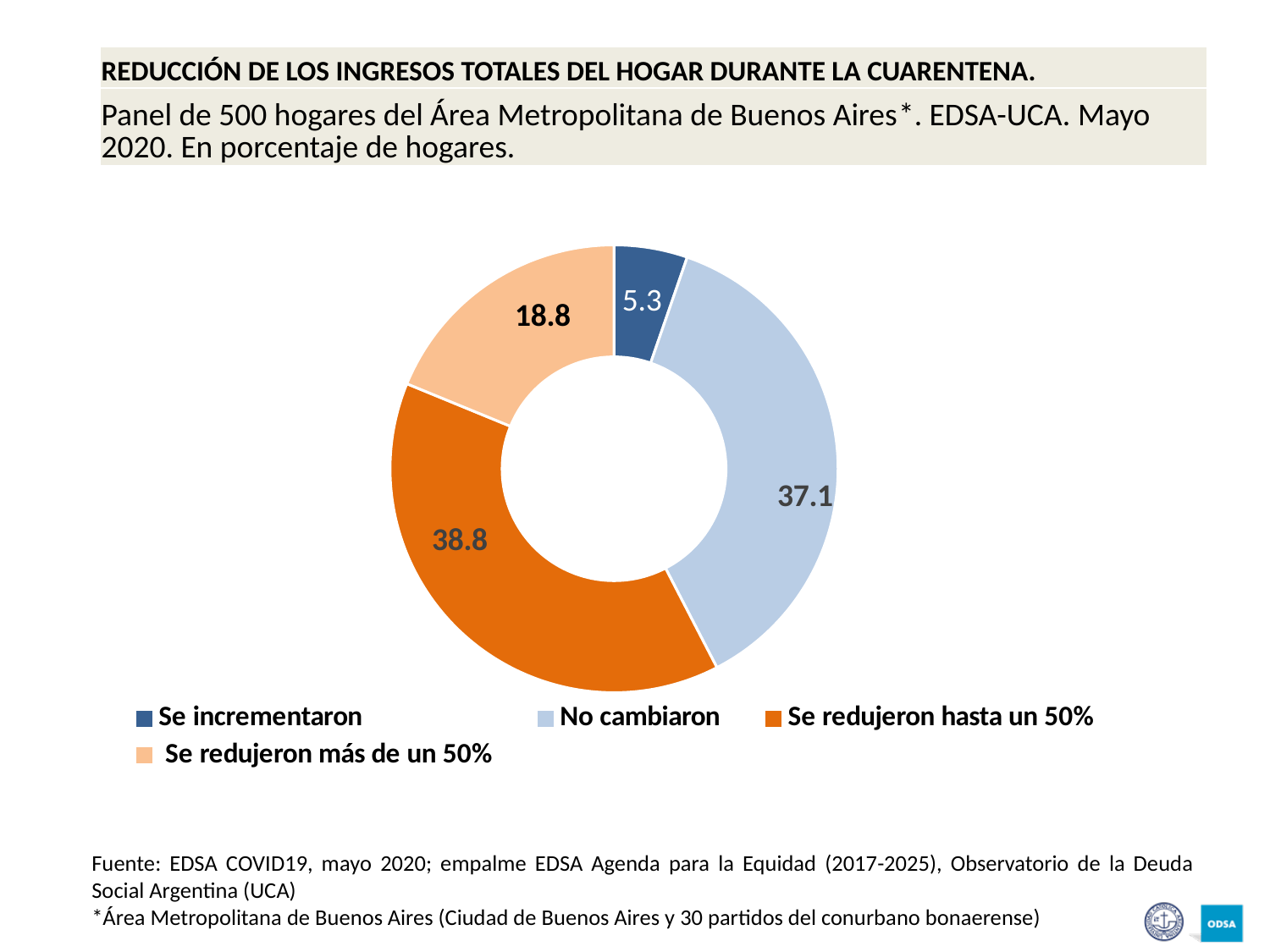
What percentage of households reported that their income 'Se incrementaron'? 5.3 Which colour represents 'Se incrementaron' in the chart? Dark blue What is the combined value of the two 'Se redujeron' categories? 57.6 What value is shown for 'Se redujeron más de un 50%'? 18.8 What kind of chart is shown on the slide? Doughnut (pie) chart Which category has the smallest share of households? Se incrementaron Which category has the largest share of households? Se redujeron hasta un 50% Which is larger: the value for 'No cambiaron' or the value for 'Se redujeron más de un 50%'? No cambiaron What is the difference between the values for 'Se redujeron hasta un 50%' and 'Se redujeron más de un 50%'? 20 What value is shown for 'No cambiaron'? 37.1 What value is shown for 'Se redujeron hasta un 50%'? 38.8 How many categories does the chart show? 4